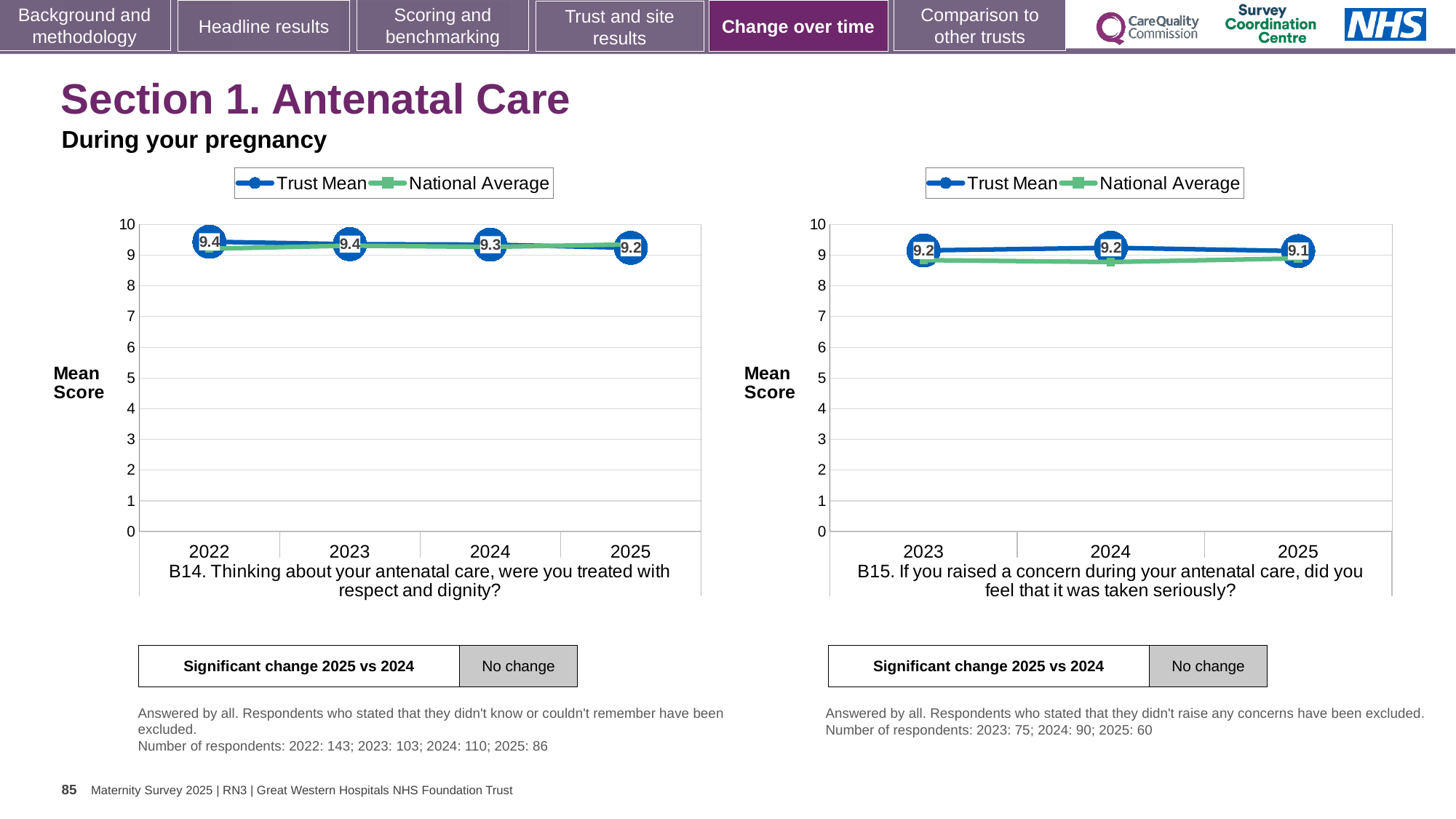
In the B14 chart (left), what is the Trust Mean for 2025? 9.2 In the B14 chart (left), what is the Trust Mean for 2022? 9.4 What kind of chart is the B14 chart (left)? Line chart In the B15 chart (right), what is the Trust Mean for 2025? 9.1 How many series does the legend of the B15 chart (right) list? 2 What are the two series named in the legend of the B14 chart (left)? Trust Mean and National Average In the B15 chart (right), is the National Average for 2024 greater or less than 8? greater In the B15 chart (right), how many years are shown on the x axis? 3 In the B14 chart (left), how many years are shown on the x axis? 4 In the B15 chart (right), what is the Trust Mean for 2024? 9.2 In the B14 chart (left), does the Trust Mean rise or fall from 2022 to 2025? Fall In the B14 chart (left), what is the difference between the Trust Mean in 2022 and in 2025? 0.2